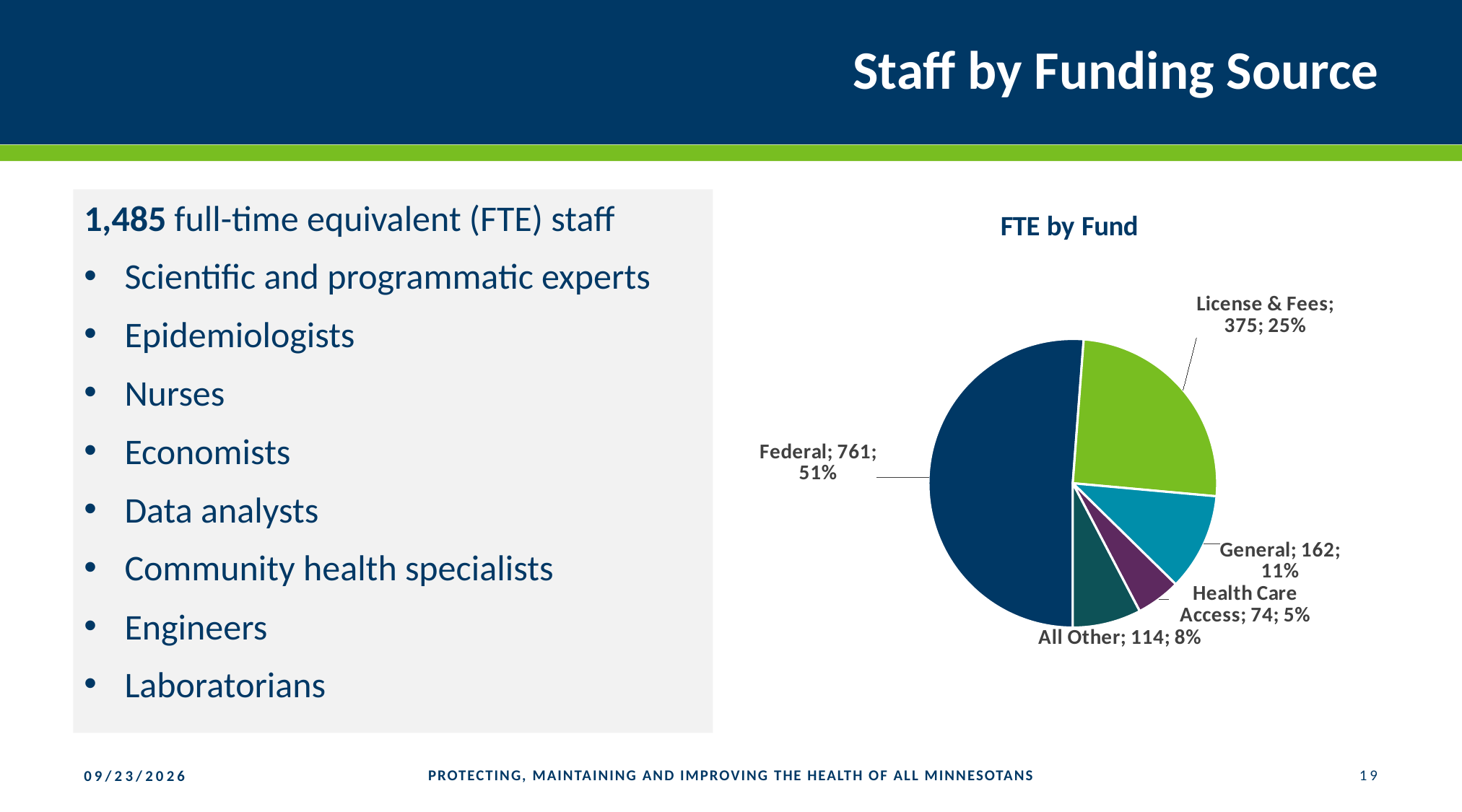
What is the difference in FTE between All Other and Health Care Access? 40 What is the title of the chart? FTE by Fund Which funding source has the largest number of FTE? Federal Which has more FTE, General or All Other? General How many funding source categories are shown in the pie chart? 5 What percentage of FTE is funded by Health Care Access? 5% What type of chart is shown on the slide? pie chart How many FTE are in the General fund category? 162 What share of the pie does License & Fees represent? 25% How many FTE are funded by Federal sources? 761 Which funding source has the smallest number of FTE? Health Care Access What is the difference in FTE between Federal and License & Fees? 386